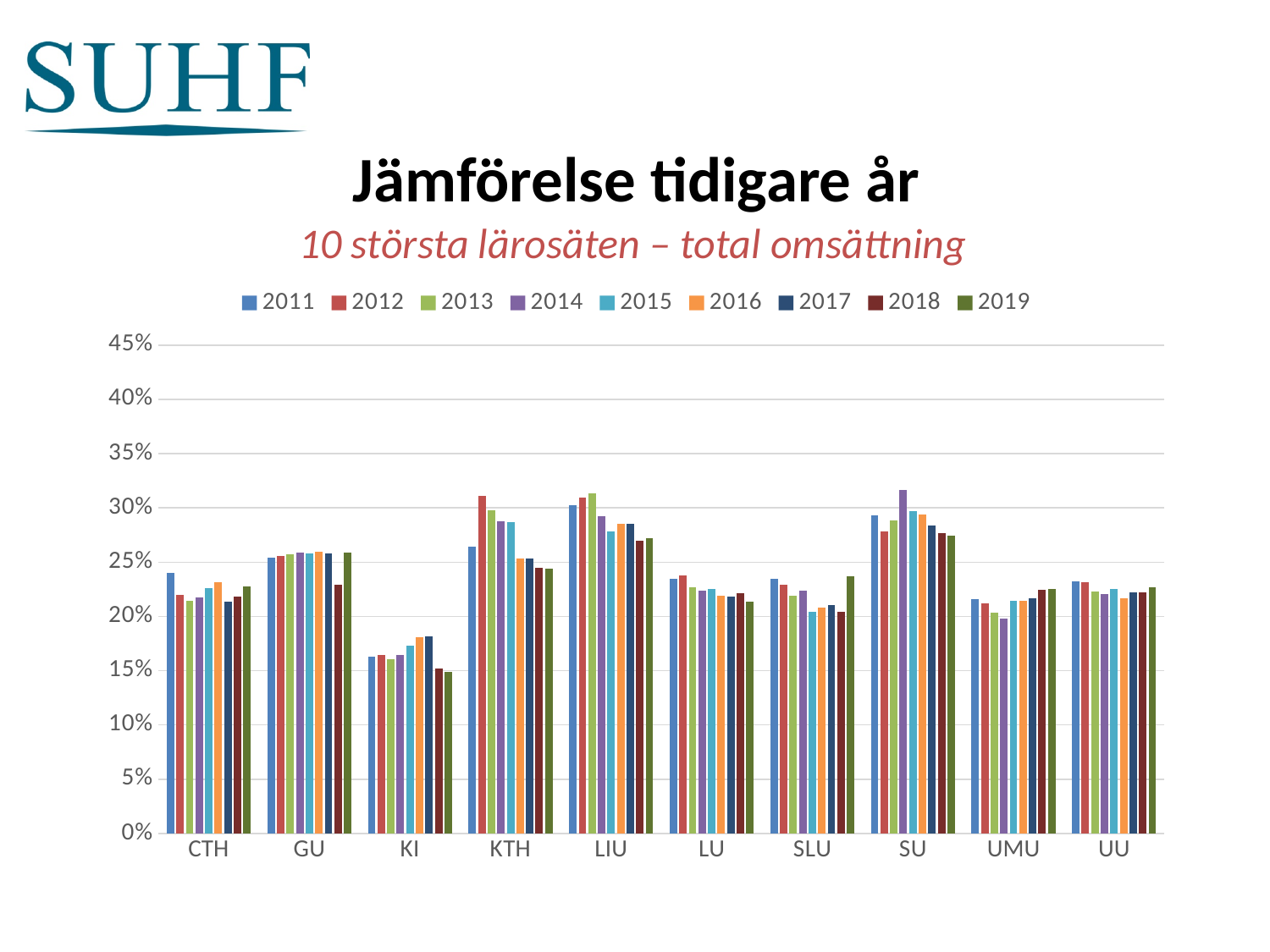
Which is larger, the 2014 value for SU or the 2014 value for UMU? SU What is the subtitle of the chart shown in red italics? 10 största lärosäten – total omsättning How many institutions (categories) are shown on the x axis? 10 Do the values for KTH rise or fall from 2012 to 2019? fall How many series does the legend list? 9 What kind of chart is shown on the slide? bar chart Is the value for KI in 2019 greater or less than 20%? less Which is larger, the 2011 value for GU or the 2011 value for KI? GU Which institution has the lowest values across all years? KI Is the value for CTH in 2011 greater or less than 25%? less Is the value for SU in 2014 greater or less than 30%? greater